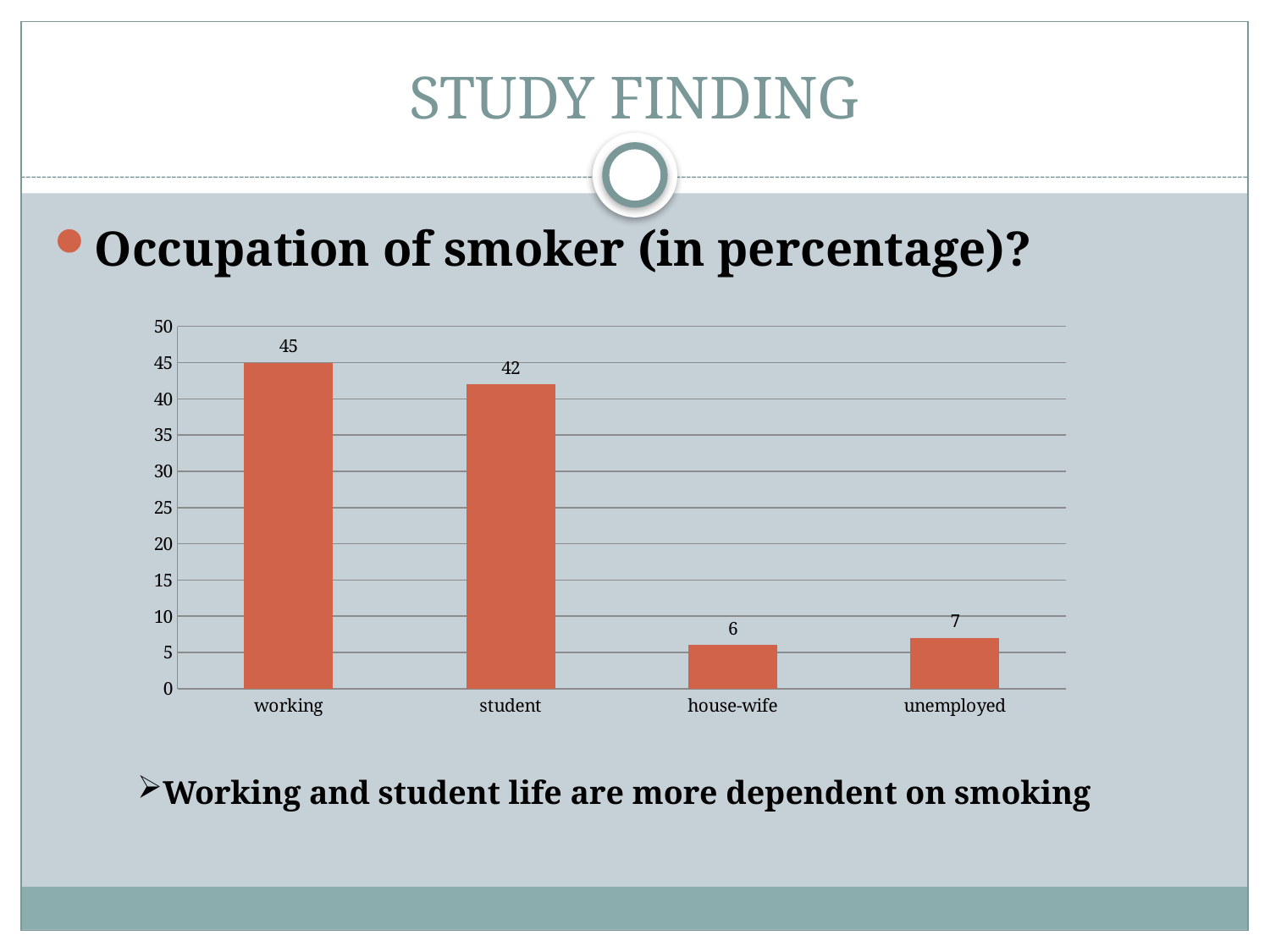
What is the value for working? 45 What is the difference between the values for unemployed and house-wife? 1 What is the value for student? 42 How many categories are shown on the x axis? 4 Which is larger, the value for student or the value for unemployed? student What is the value for house-wife? 6 Which category has the lowest value? house-wife Is the value for student greater or less than 40? greater What kind of chart is shown on the slide? bar chart Which category has the highest value? working What is the value for unemployed? 7 What is the difference between the values for working and student? 3